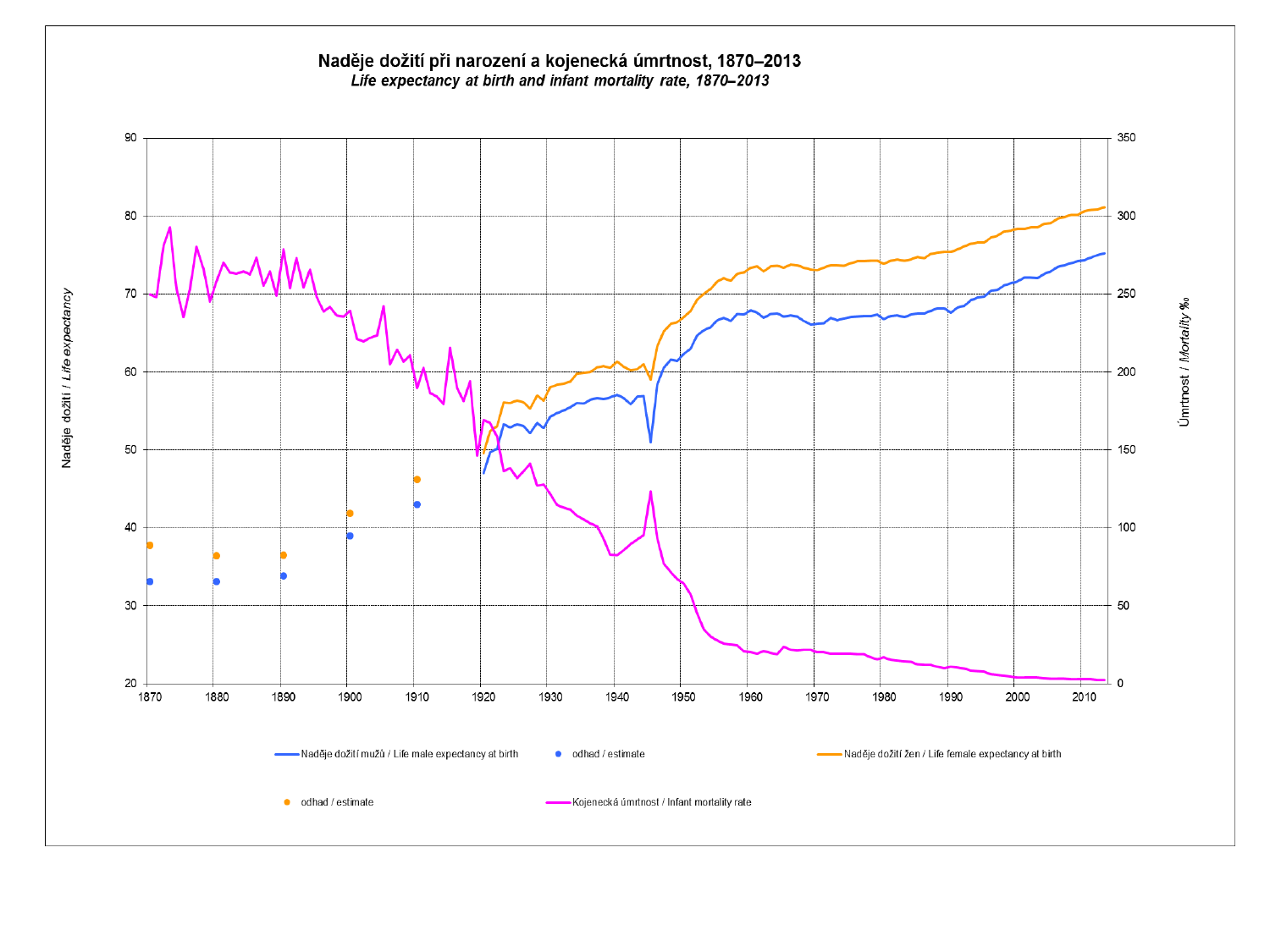
Is the life male expectancy at birth in 2010 greater or less than 70? greater Does the infant mortality rate rise or fall from 1870 to 2013? fall In 2010, which is higher: life female expectancy at birth or life male expectancy at birth? life female expectancy at birth Is the infant mortality rate in 1870 greater or less than 200‰? greater What is the English title of the chart? Life expectancy at birth and infant mortality rate, 1870–2013 Is the life female expectancy at birth in 2013 greater or less than 75? greater Which is higher: the infant mortality rate in 1945 or in 1950? 1945 What kind of chart is shown on the slide? line chart How many entries does the legend list? 5 Does the female life expectancy at birth rise or fall from 1920 to 2013? rise